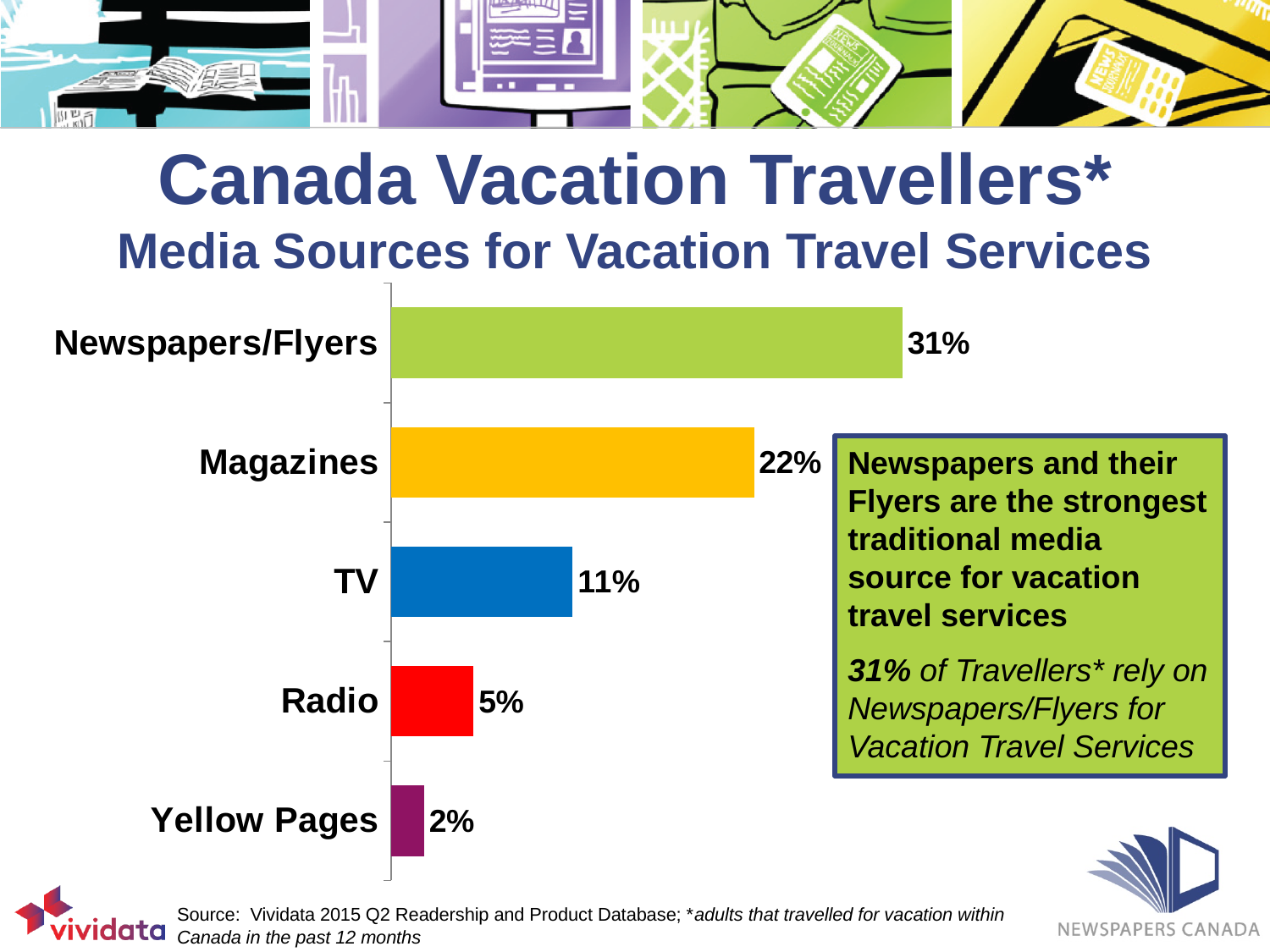
What is the difference between the values for Newspapers/Flyers and Magazines? 9% What is the value for Magazines? 22% What is the value for Yellow Pages? 2% What colour is the bar for Magazines? Yellow What is the value for TV? 11% What is the value for Newspapers/Flyers? 31% What is the value for Radio? 5% Which is larger, the value for TV or the value for Radio? TV How many media sources are shown in the chart? 5 Which media source has the lowest value? Yellow Pages What kind of chart is shown on the slide? Bar chart Which media source has the highest value? Newspapers/Flyers